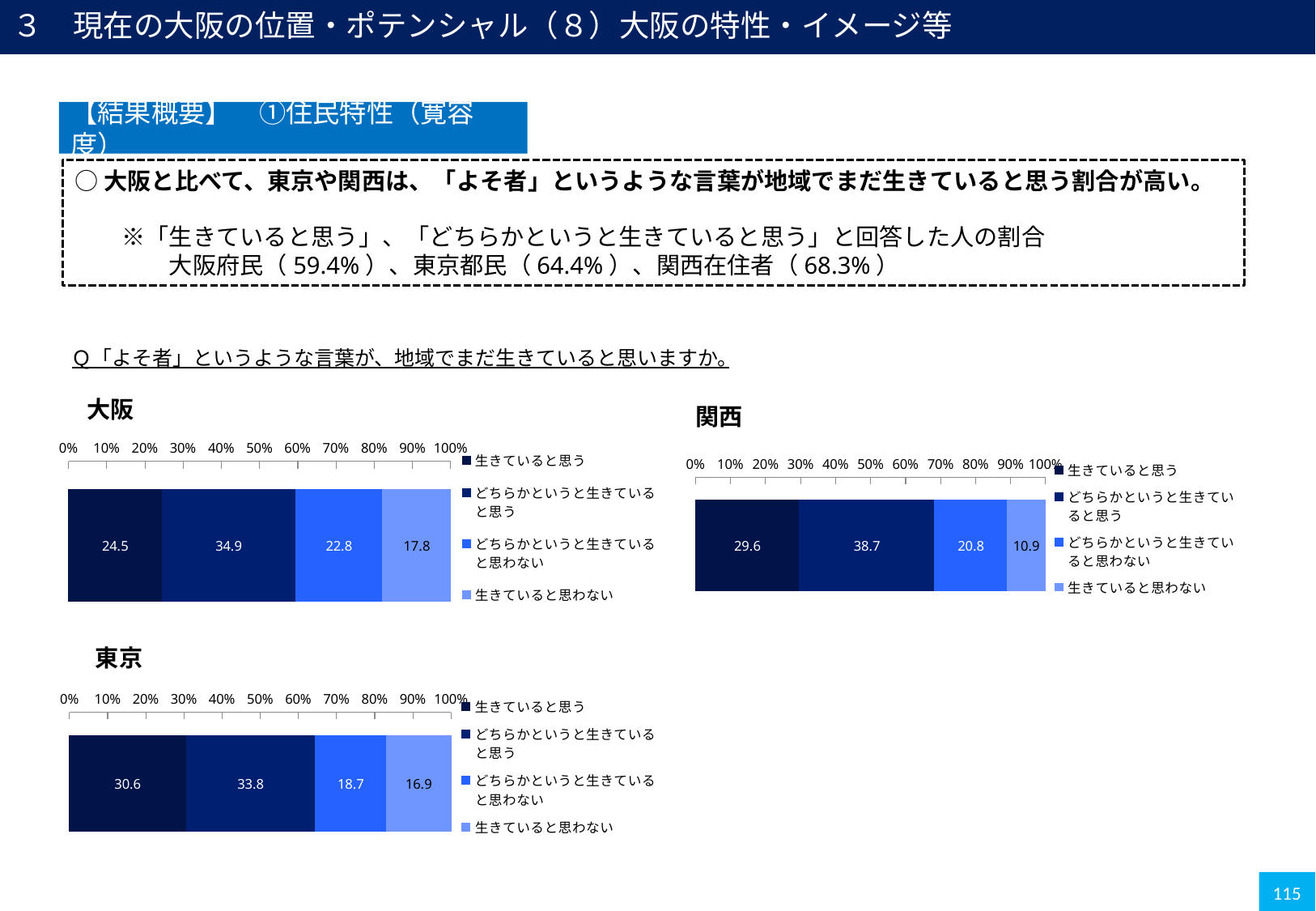
How many series does the legend of the 東京 chart list? 4 Which is larger: the 生きていると思う value in the 東京 chart or in the 大阪 chart? 東京 In the 関西 chart, what is the value for 生きていると思わない? 10.9 In the 関西 chart, what is the value for どちらかというと生きていると思う? 38.7 How many charts are shown on the slide? 3 In the 東京 chart, what is the difference between 生きていると思う and 生きていると思わない? 13.7 What kind of chart is the 関西 chart? Stacked bar chart In the 大阪 chart, what is the combined value of 生きていると思う and どちらかというと生きていると思う? 59.4 In the 東京 chart, what is the value for 生きていると思わない? 16.9 In the 大阪 chart, which segment has the largest value? どちらかというと生きていると思う In the 関西 chart, which segment has the smallest value? 生きていると思わない In the 大阪 chart, what is the value for 生きていると思う? 24.5